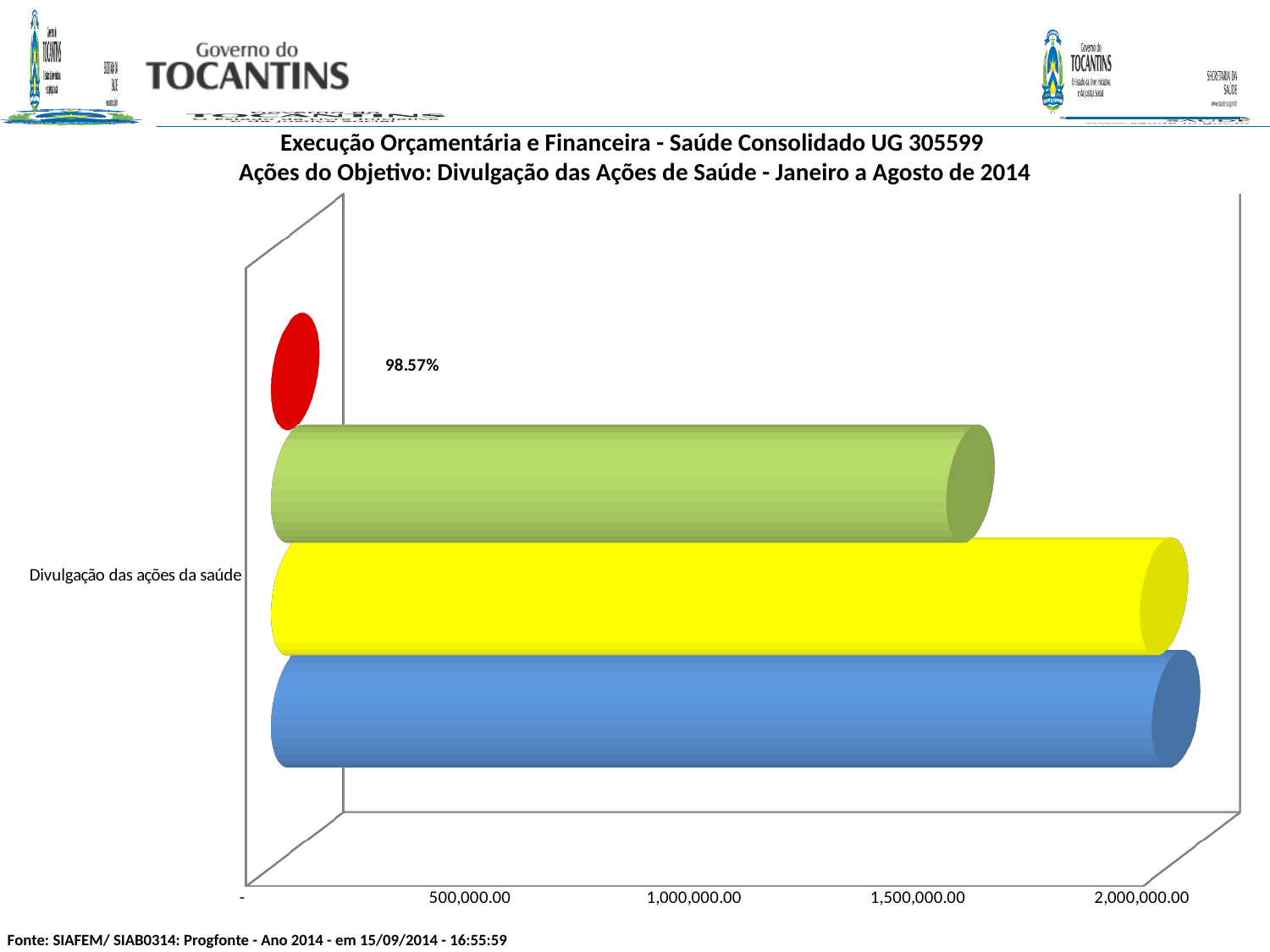
How many categories are shown on the vertical axis of the chart? 1 Which bar is longer, the blue bar or the green bar? the blue bar Which bar is the shortest on the chart? the red bar What is the highest value labelled on the horizontal axis of the chart? 2,000,000.00 Is the value of the yellow bar greater or less than 1,000,000.00? greater Is the value of the blue bar greater or less than 1,500,000.00? greater Which bar is longer, the yellow bar or the green bar? the yellow bar What kind of chart is shown on the slide? bar chart Is the value of the red bar greater or less than 500,000.00? less What is the category label shown on the vertical axis of the chart? Divulgação das ações da saúde What percentage value is printed as a data label on the chart? 98.57%